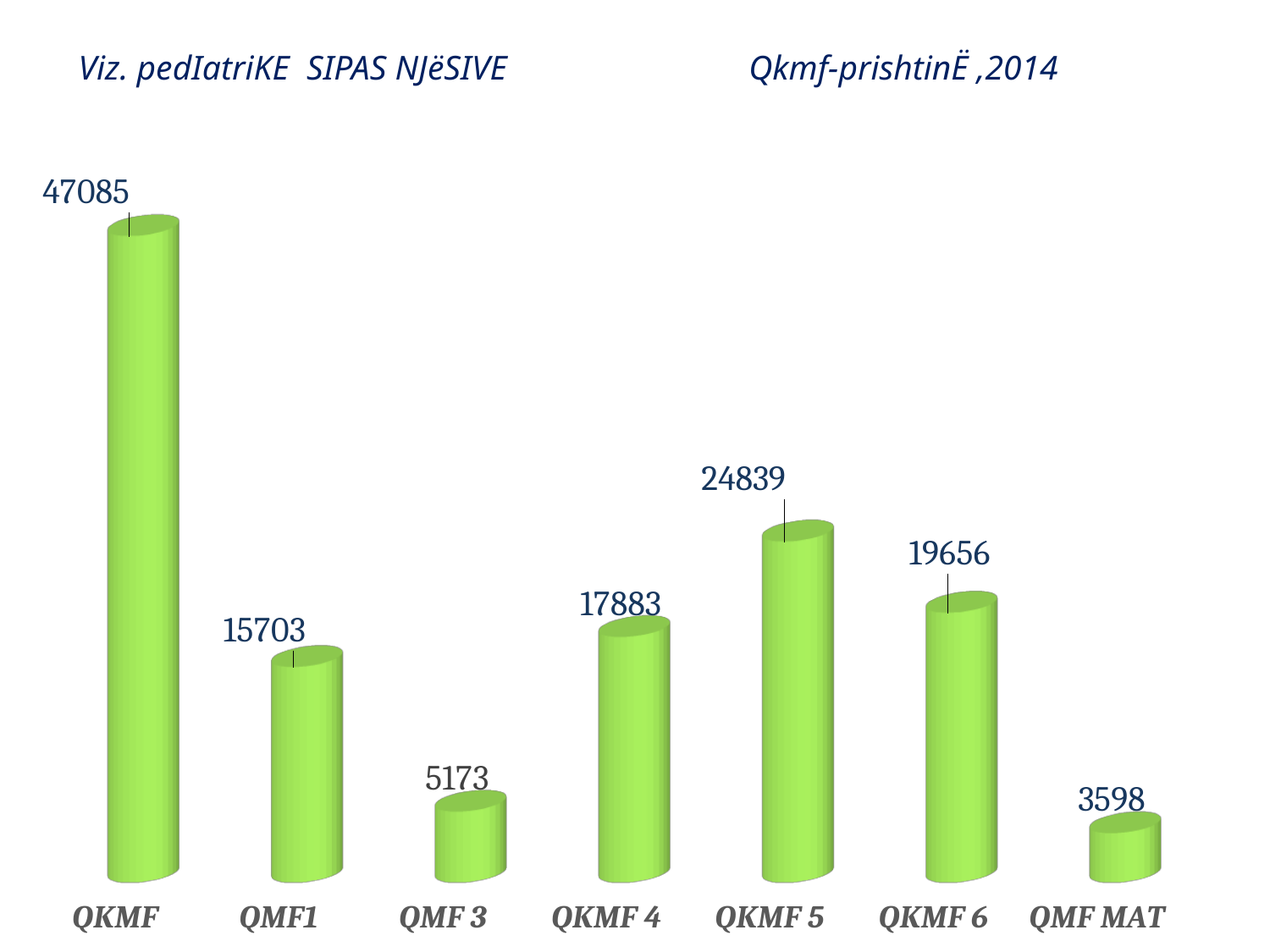
Which category has the highest value? QKMF Which is larger, the value for QKMF 6 or the value for QKMF 4? QKMF 6 What is the difference between the values for QKMF 5 and QKMF 6? 5183 What is the difference between the values for QKMF 4 and QMF 3? 12710 What is the value for QMF1? 15703 What colour are the bars in the chart? green Which category has the lowest value? QMF MAT What is the value for QKMF 5? 24839 What kind of chart is shown on the slide? bar chart What is the value for QKMF? 47085 How many categories are shown on the chart? 7 What is the value for QMF MAT? 3598